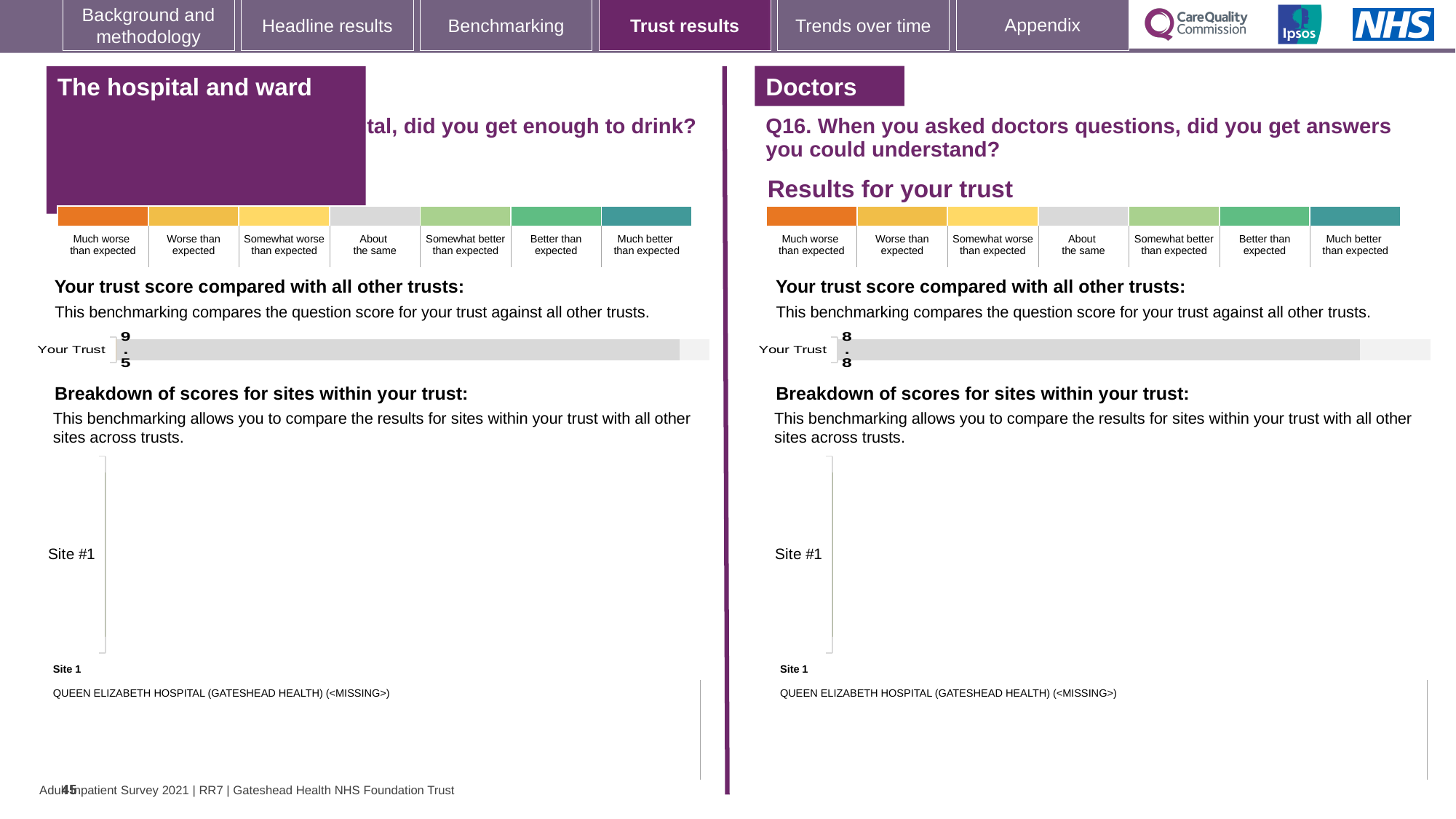
In the 'Breakdown of scores for sites within your trust' chart on the right side, how many sites are listed? 1 What kind of chart is used to show 'Your Trust' score on the left side of the slide? Bar chart On the right chart for Q16 (Doctors), what is the value shown for Your Trust? 8.8 What is the label of the single category plotted in the trust score chart on the left side of the slide? Your Trust How many categories are plotted in the 'Your trust score compared with all other trusts' chart on the right side of the slide? 1 What is the difference between the Your Trust score on the left chart (9.5) and the Your Trust score on the right chart (8.8)? 0.7 Is the Your Trust value on the left chart (enough to drink) greater or less than 9? greater Is the Your Trust value on the right chart (Q16) greater or less than 9? less What is the site label shown on the y axis of the site breakdown chart on the left side of the slide? Site #1 On the left chart under 'Your trust score compared with all other trusts', what is the value shown for Your Trust? 9.5 Which is larger: the Your Trust score on the left chart (enough to drink) or on the right chart (Q16, doctors' answers)? The left chart (9.5)